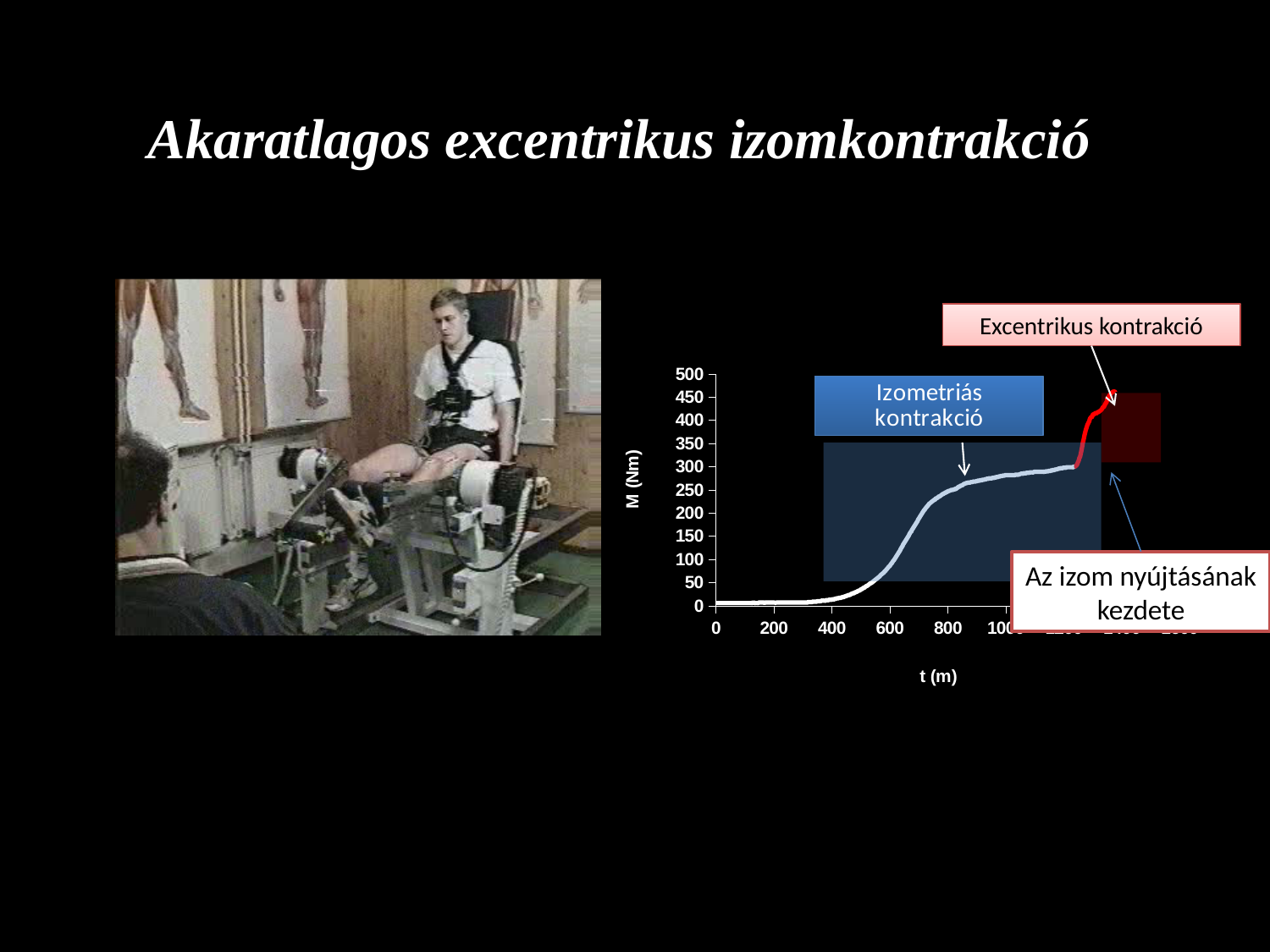
What kind of chart is shown on the right side of the slide? line chart What is the highest tick value shown on the vertical axis of the chart? 500 Is the value of M at t = 1200 greater or less than 250? greater What is the label of the vertical axis of the chart? M (Nm) Is the value of M at t = 400 greater or less than 50? less Is the value of M at t = 200 greater or less than 50? less What is the label of the horizontal axis of the chart? t (m) Does the plotted value rise or fall as t increases along the x axis? rise